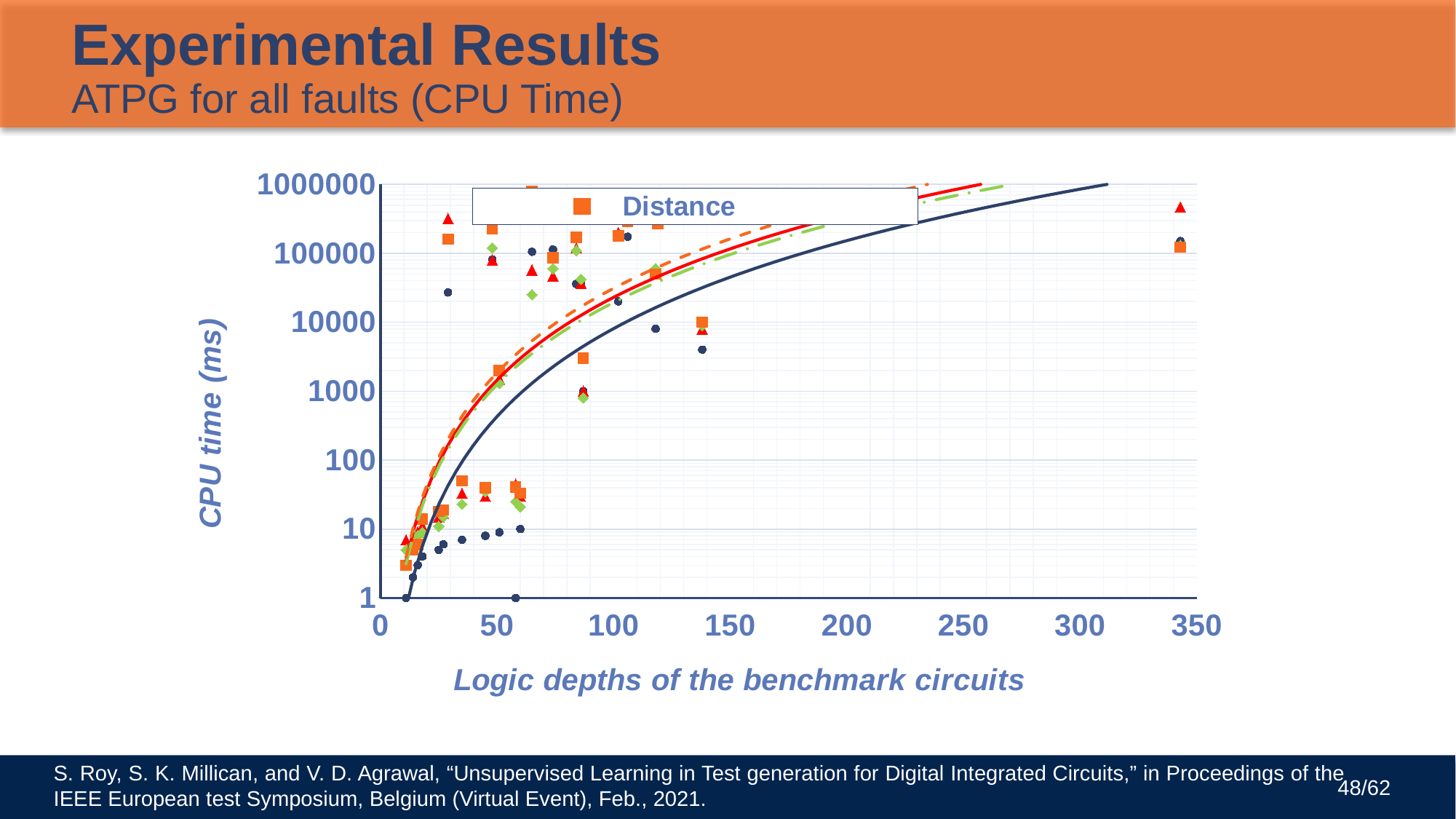
Is the Distance series value at the largest logic depth (around 345) greater or less than 10000? greater Which series name is shown in the chart's legend? Distance What is the highest tick value shown on the horizontal axis? 350 What is the highest tick value shown on the vertical axis? 1000000 Is the Distance series value at a logic depth of about 85 greater or less than 1000? greater Do the fitted trend lines rise or fall as logic depth increases along the x axis? Rise What is the title of the horizontal axis of the chart? Logic depths of the benchmark circuits What kind of chart is shown on the slide? Scatter chart What is the title of the vertical axis of the chart? CPU time (ms) Is the Distance series value at a logic depth of about 35 greater or less than 100? less